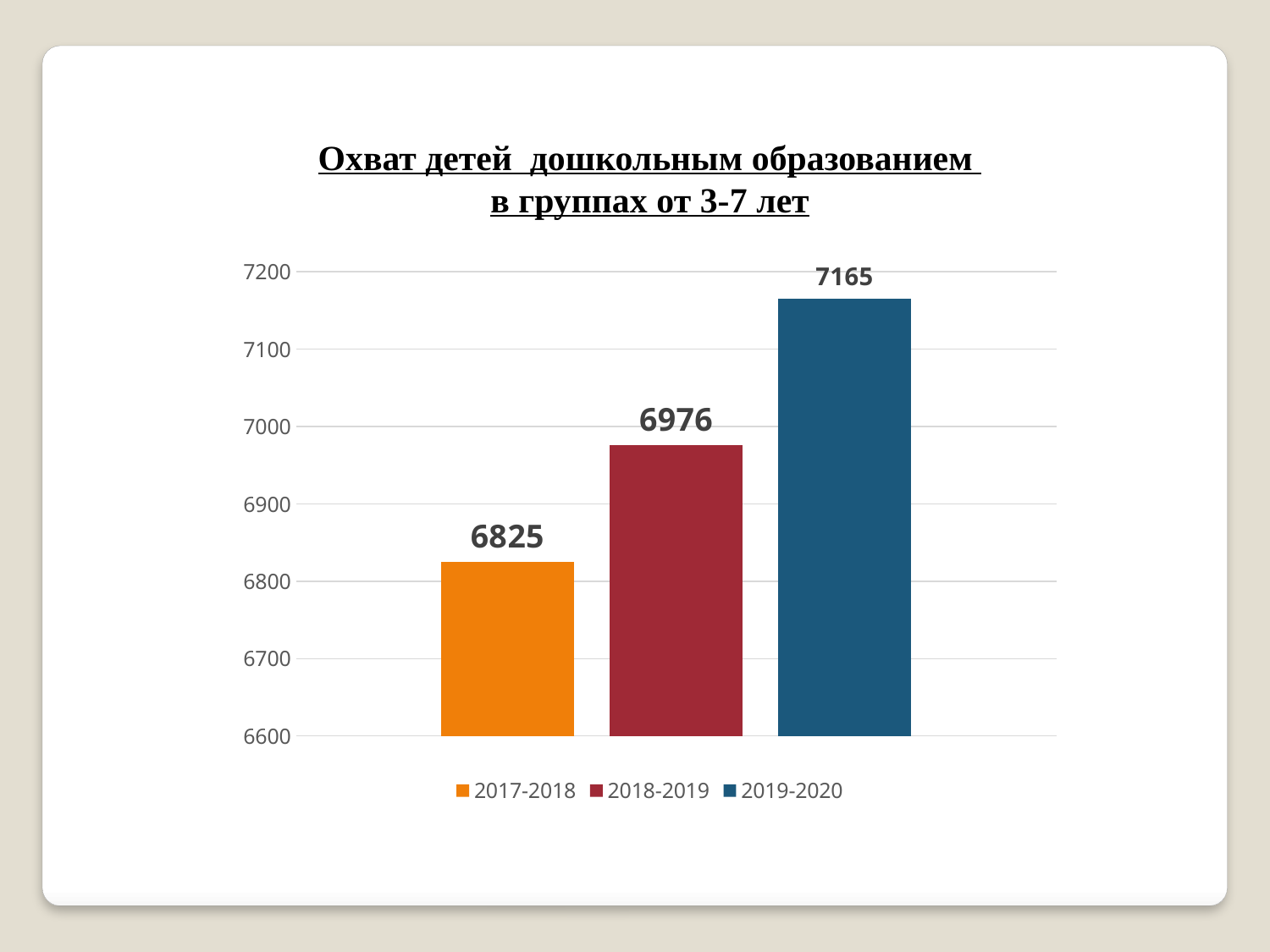
What is the value for 2018-2019? 6976 Which is larger, the value for 2018-2019 or the value for 2019-2020? 2019-2020 What is the value for 2019-2020? 7165 What kind of chart is shown on the slide? bar chart Which period has the highest value? 2019-2020 What is the value for 2017-2018? 6825 How many bars are shown in the chart? 3 Which period has the lowest value? 2017-2018 Do the values rise or fall from 2017-2018 to 2019-2020? rise What is the difference between the values for 2019-2020 and 2017-2018? 340 Is the value for 2018-2019 greater or less than 7000? less What is the difference between the values for 2018-2019 and 2017-2018? 151